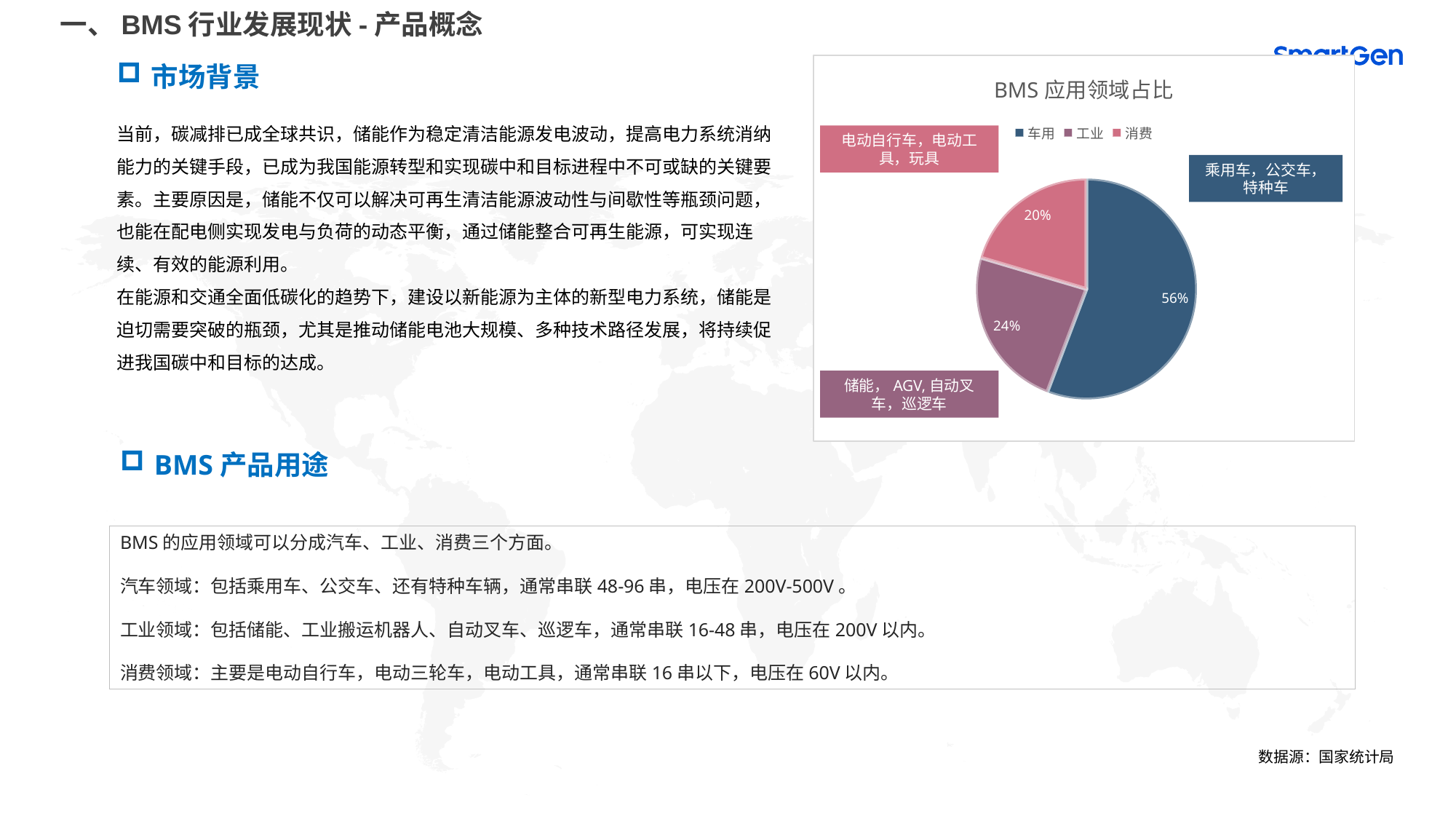
What share of the pie does 消费 have? 20% What kind of chart is shown on the slide? pie chart What is the difference in percentage points between the 工业 share and the 消费 share? 4 What share of the pie does 工业 have? 24% What share of the pie does 车用 have? 56% What is the difference in percentage points between the 车用 share and the 工业 share? 32 Which is larger, the share for 工业 or the share for 消费? 工业 Which category has the smallest share of the pie? 消费 How many entries does the legend list? 3 How many categories does the pie chart have? 3 What is the title of the chart? BMS 应用领域占比 Which category has the largest share of the pie? 车用